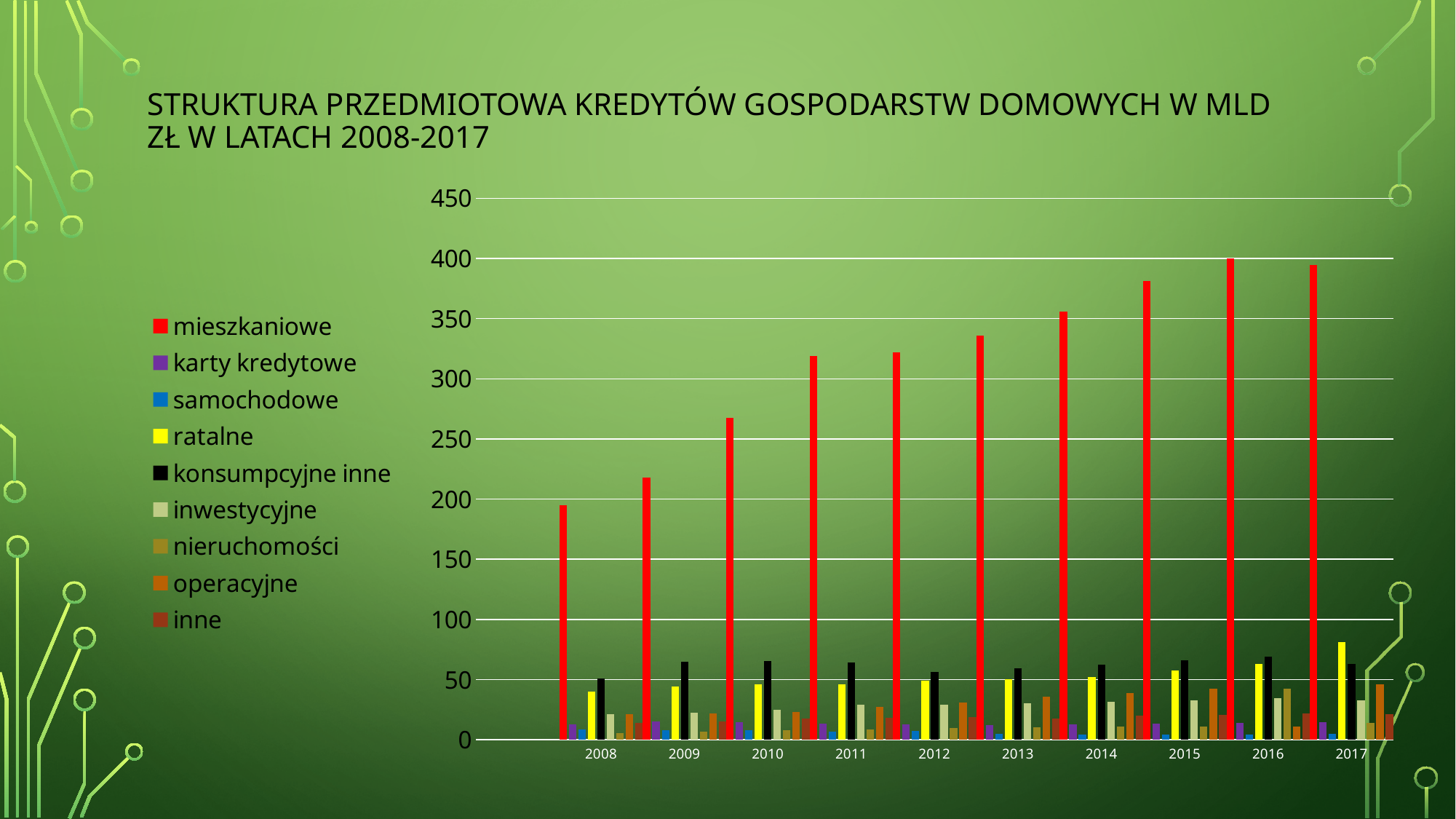
Does the value for mieszkaniowe rise or fall from 2008 to 2016? rise Which is larger, the value for mieszkaniowe in 2009 or in 2010? 2010 Is the value for mieszkaniowe in 2008 greater or less than 200? less Is the value for mieszkaniowe in 2010 greater or less than 250? greater How many years are shown on the x axis? 10 Which series is shown in red? mieszkaniowe What kind of chart is shown on the slide? bar chart Is the value for mieszkaniowe in 2014 greater or less than 350? greater How many series does the legend list? 9 Which series is listed last in the legend? inne Which year has the lowest value for mieszkaniowe? 2008